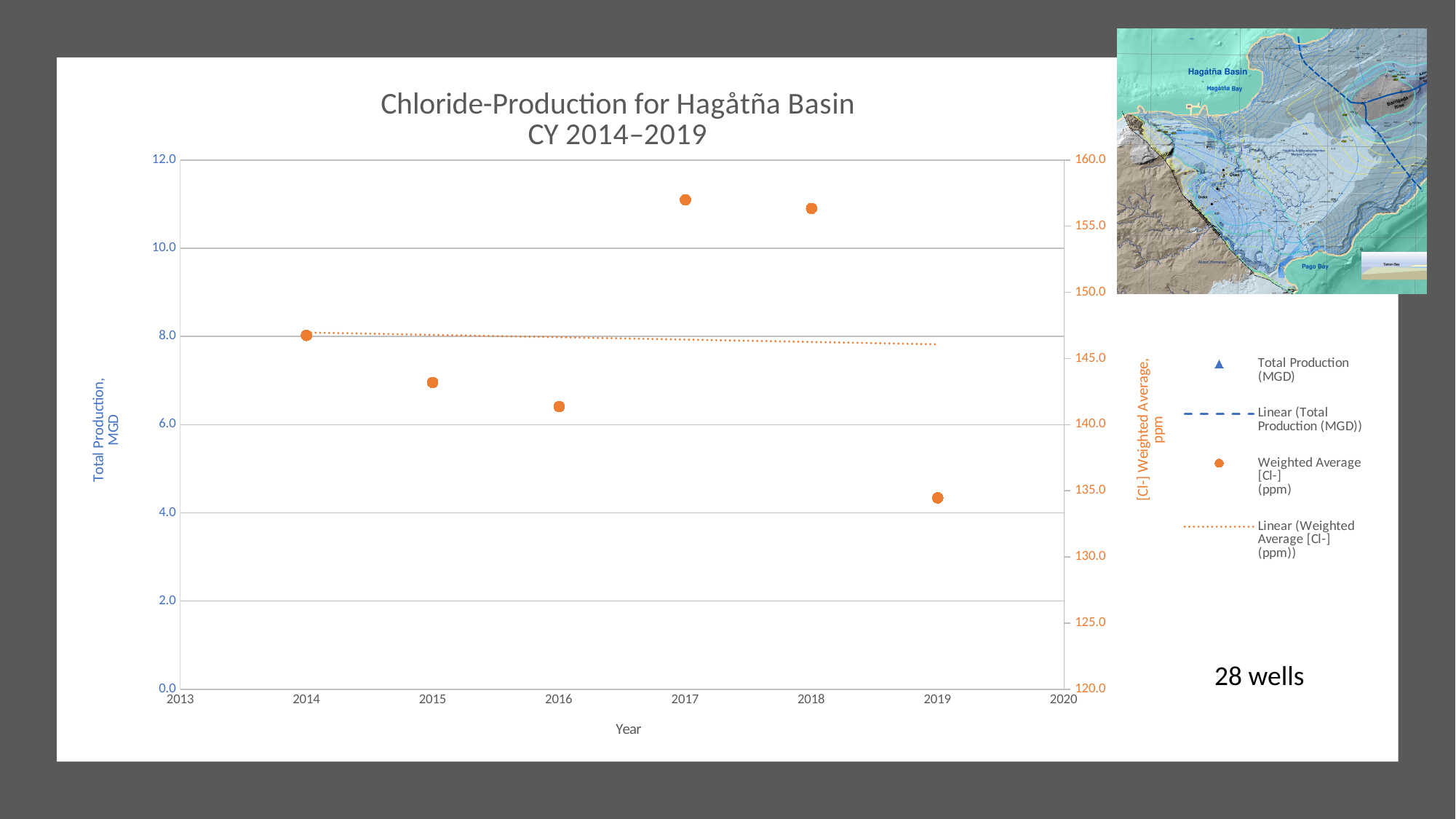
Which year has the larger Weighted Average [Cl-] value, 2016 or 2019? 2016 What is the title of the chart? Chloride-Production for Hagåtña Basin CY 2014–2019 How many entries does the chart legend list? 4 Is the Weighted Average [Cl-] value for 2019 greater or less than 140.0 ppm? less Is the Weighted Average [Cl-] value for 2017 greater or less than 155.0 ppm? greater Which year has the lowest Weighted Average [Cl-] (ppm) value? 2019 Does the dotted linear trendline for Weighted Average [Cl-] rise or fall from 2014 to 2019? fall Which year has the larger Weighted Average [Cl-] value, 2014 or 2015? 2014 How many orange Weighted Average [Cl-] data points are plotted on the chart? 6 What kind of chart is shown on the slide? scatter chart Is the Weighted Average [Cl-] value for 2016 greater or less than 140.0 ppm? greater